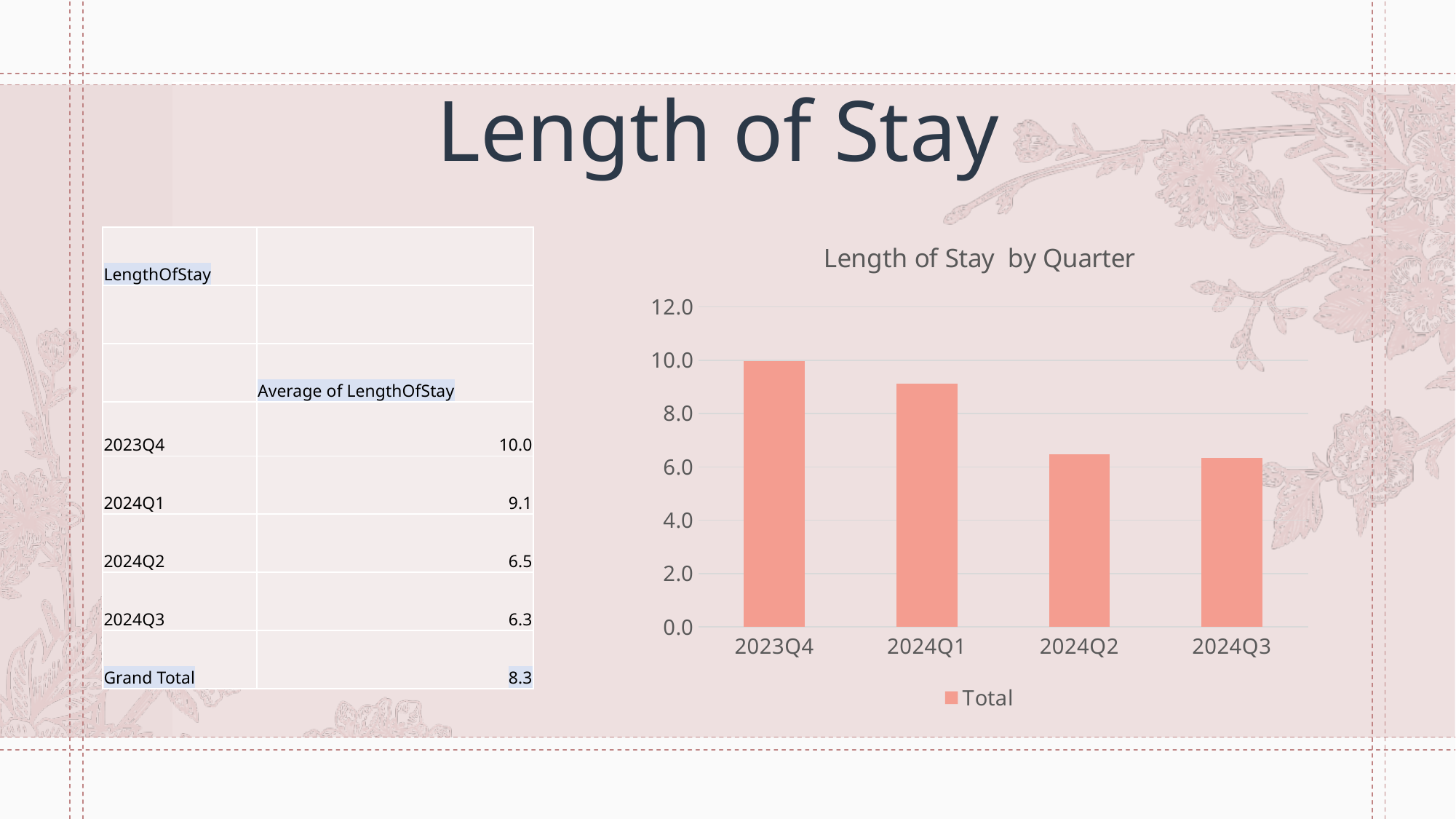
Is the value for 2024Q1 in the chart greater or less than 8.0? greater Using the table values, what is the difference in average length of stay between 2023Q4 and 2024Q1? 0.9 Do the values in the chart rise or fall from 2023Q4 to 2024Q3? fall What is the title of the chart? Length of Stay by Quarter How many series does the chart legend list? 1 Which quarter has the lowest length of stay in the chart? 2024Q3 What type of chart is shown on the slide? bar chart How many quarters are plotted in the chart? 4 According to the table, what is the Grand Total average length of stay? 8.3 According to the table, what is the average length of stay for 2024Q2? 6.5 Which quarter has the highest length of stay in the chart? 2023Q4 According to the table, what is the average length of stay for 2023Q4? 10.0